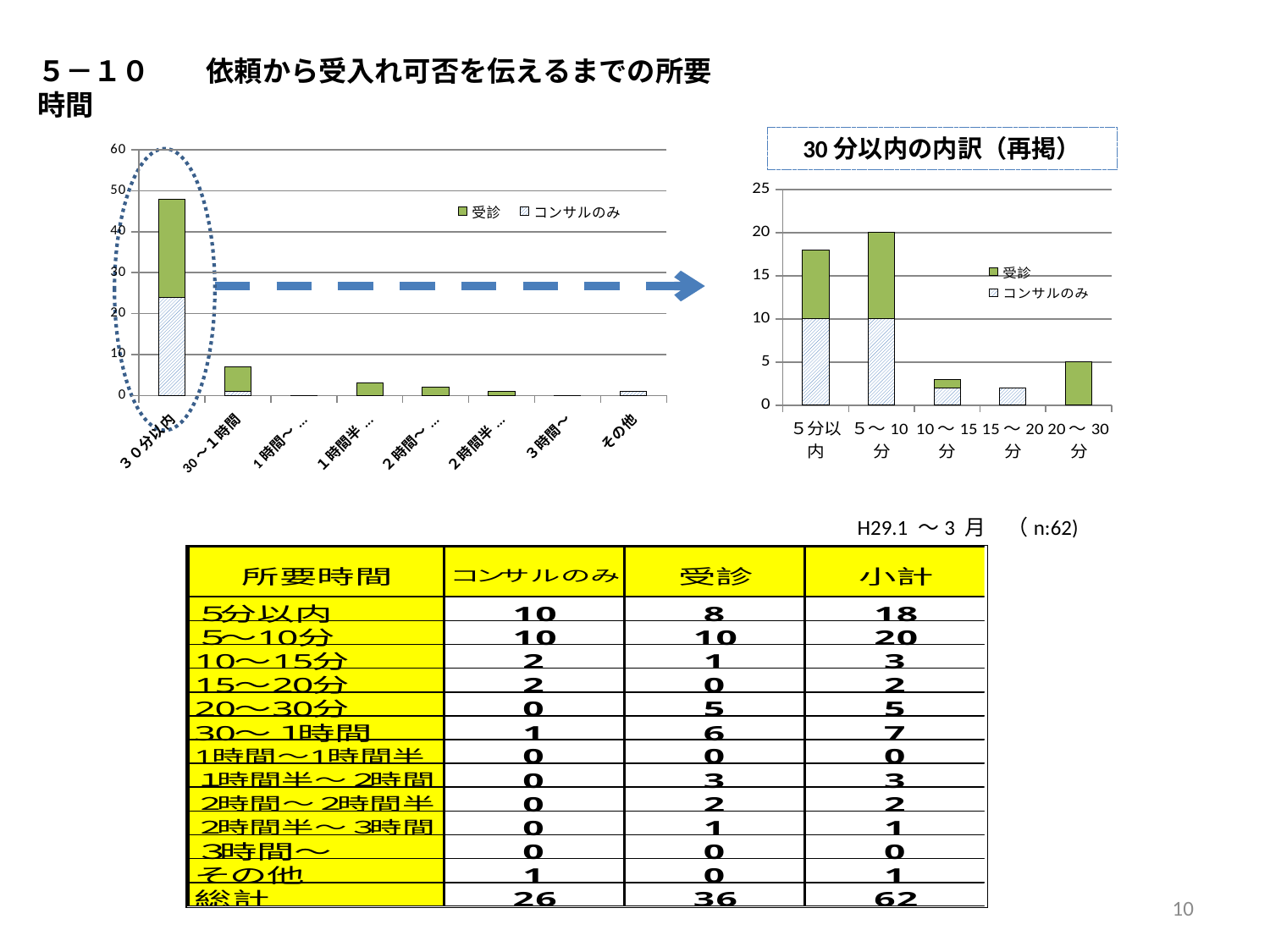
In the left chart, which category has the tallest stacked bar? ３０分以内 In the right chart (30分以内の内訳（再掲）), what is the total height of the stacked bar for 5〜10分? 20 How many categories are shown on the x axis of the right chart (30分以内の内訳（再掲）)? 5 How many categories are shown on the x axis of the left chart? 8 In the right chart (30分以内の内訳（再掲）), which bar is taller: 20〜30分 or 15〜20分? 20〜30分 How many series does the legend of the right chart (30分以内の内訳（再掲）) list? 2 In the right chart (30分以内の内訳（再掲）), is the total value for 5分以内 greater or less than 15? greater In the left chart, is the total value for ３０分以内 greater or less than 40? greater In the right chart (30分以内の内訳（再掲）), what is the コンサルのみ value for 5分以内? 10 What is the title of the right chart? 30分以内の内訳（再掲） In the right chart (30分以内の内訳（再掲）), which category has the tallest stacked bar? 5〜10分 What kind of chart is the left chart on the slide? bar chart